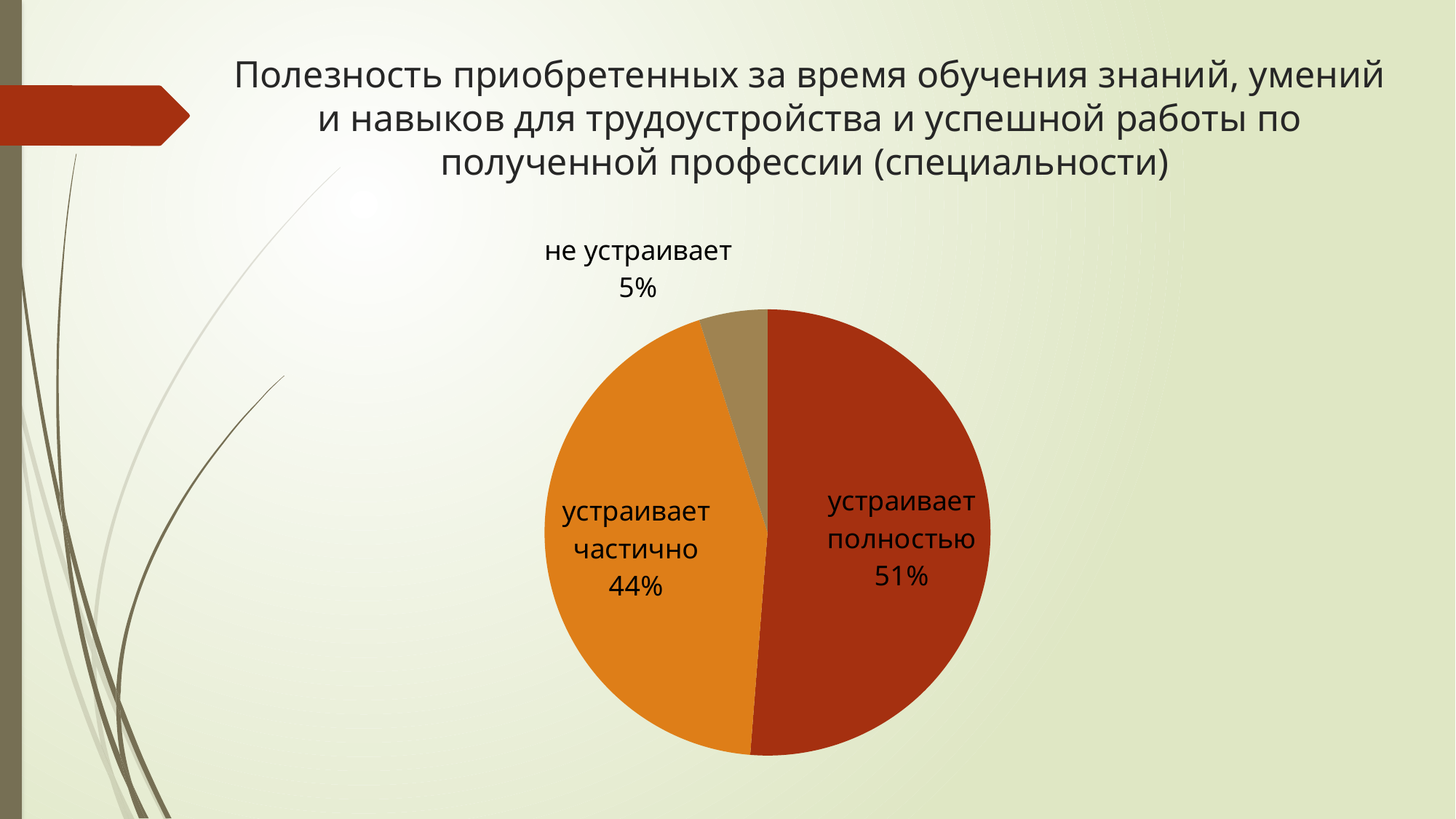
What is the difference in percentage points between "устраивает частично" and "не устраивает"? 39 What share of the pie does "устраивает частично" take? 44% Which category has the smallest slice of the pie? не устраивает Which is larger: the share for "устраивает частично" or the share for "не устраивает"? устраивает частично What kind of chart is shown on the slide? pie chart How many categories are shown in the pie chart? 3 What share of the pie does "не устраивает" take? 5% What is the combined share of "устраивает полностью" and "устраивает частично"? 95% What is the difference in percentage points between "устраивает полностью" and "устраивает частично"? 7 Which category has the largest slice of the pie? устраивает полностью What colour is the slice for "устраивает частично"? orange What share of the pie does "устраивает полностью" take? 51%